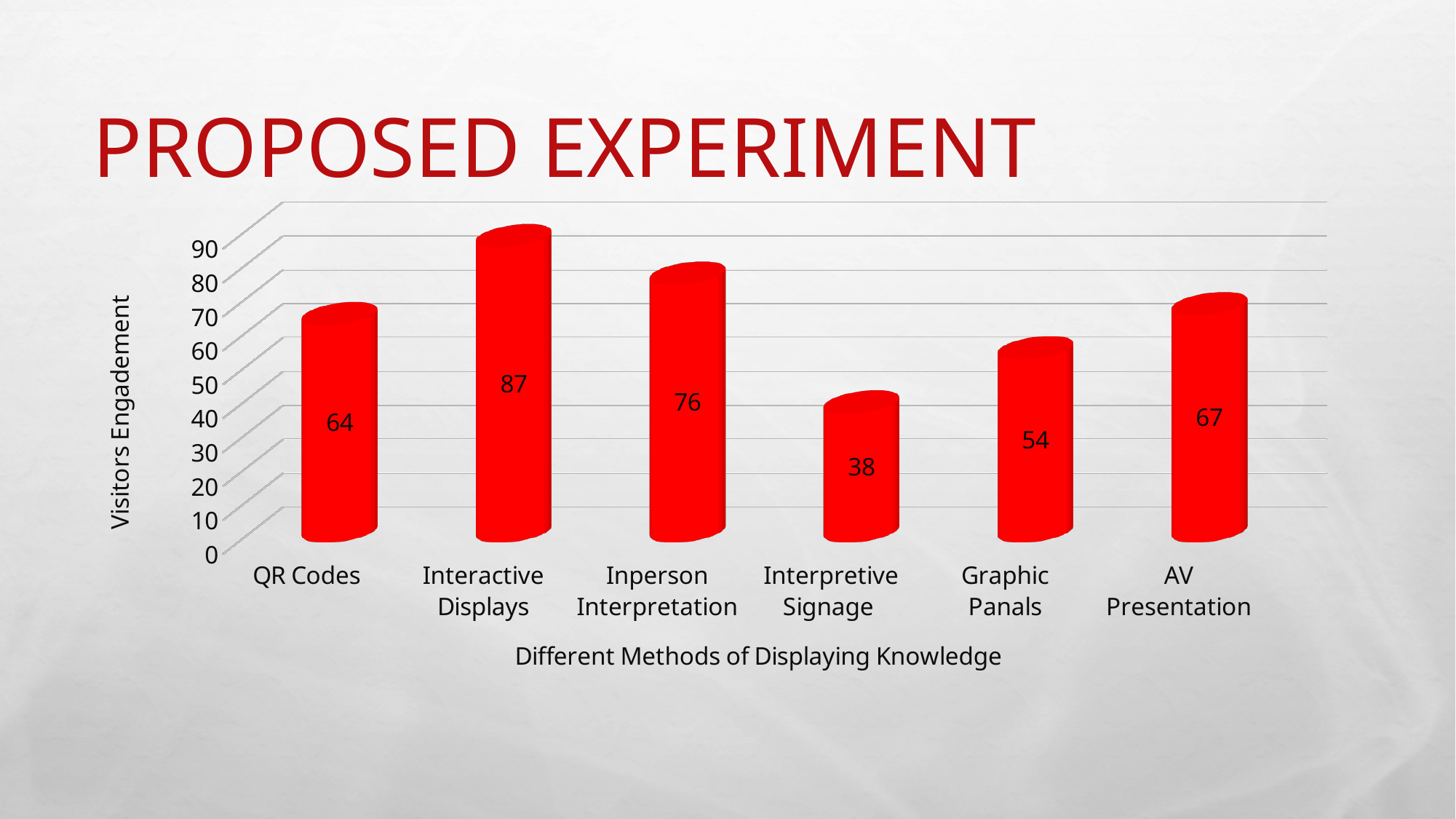
Which method has the lowest Visitors Engagement? Interpretive Signage What is the difference in Visitors Engagement between Interactive Displays and Interpretive Signage? 49 What is the label of the x axis of the chart? Different Methods of Displaying Knowledge What is the Visitors Engagement value for Interactive Displays? 87 What kind of chart is shown on the slide? Bar chart Which has a higher Visitors Engagement value, Inperson Interpretation or AV Presentation? Inperson Interpretation How many methods of displaying knowledge are shown on the chart? 6 What is the Visitors Engagement value for Graphic Panals? 54 Which method has the highest Visitors Engagement? Interactive Displays Is the value for Graphic Panals greater or less than 60? less What is the Visitors Engagement value for Interpretive Signage? 38 What is the Visitors Engagement value for QR Codes? 64